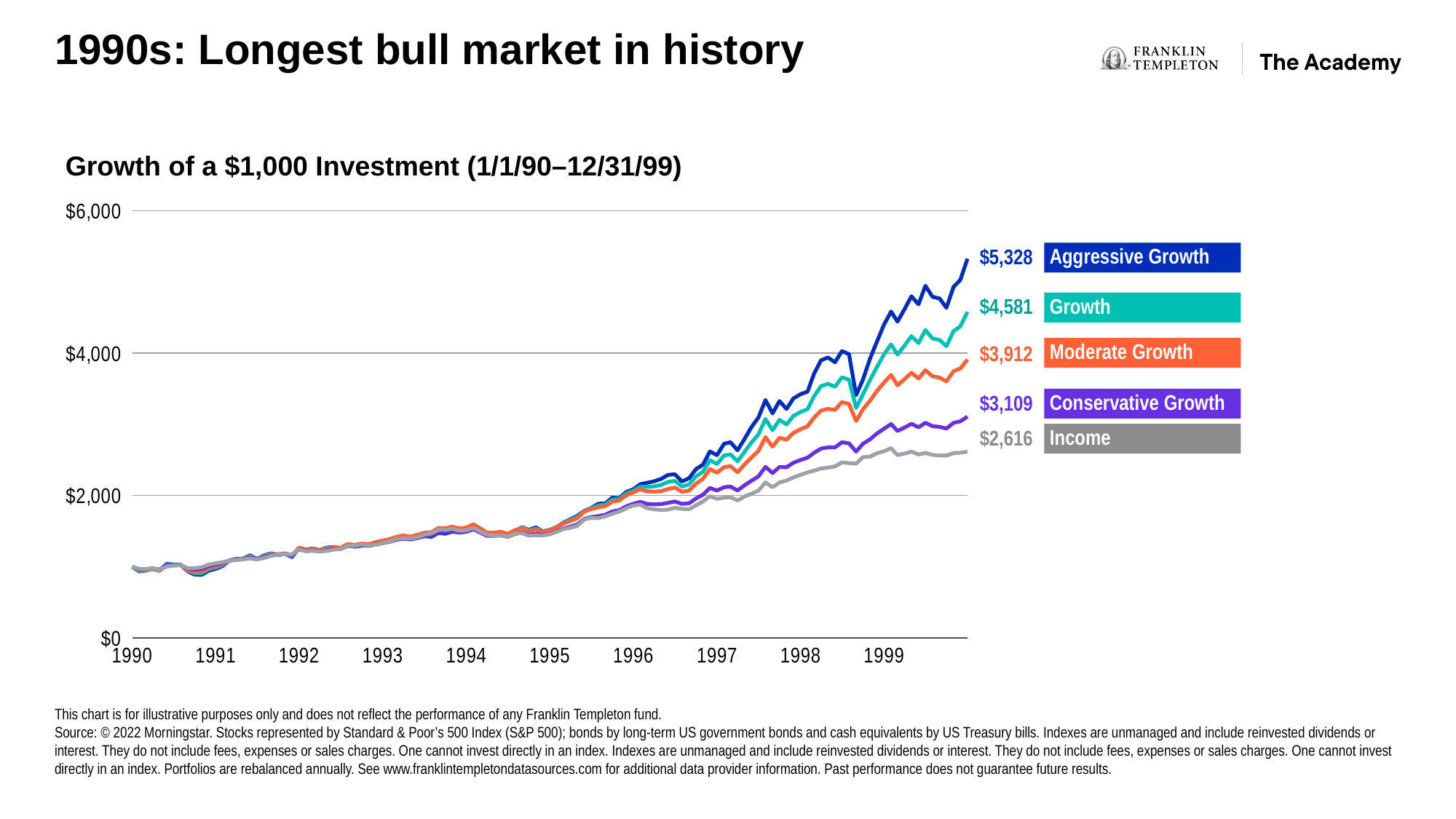
What is the difference between the ending values of Aggressive Growth and Growth? $747 Which portfolio has the highest ending value? Aggressive Growth What is the ending value of the Moderate Growth portfolio? $3,912 What is the ending value of the Income portfolio? $2,616 What is the ending value of the Aggressive Growth portfolio? $5,328 Which has a larger ending value, Growth or Moderate Growth? Growth Which portfolio has the lowest ending value? Income How many portfolios (series) are shown on the chart? 5 What is the difference between the ending values of Conservative Growth and Income? $493 What kind of chart is shown on the slide? Line chart Do the portfolio values generally rise or fall from 1990 to 1999? Rise Is the ending value for Conservative Growth greater or less than $4,000? less